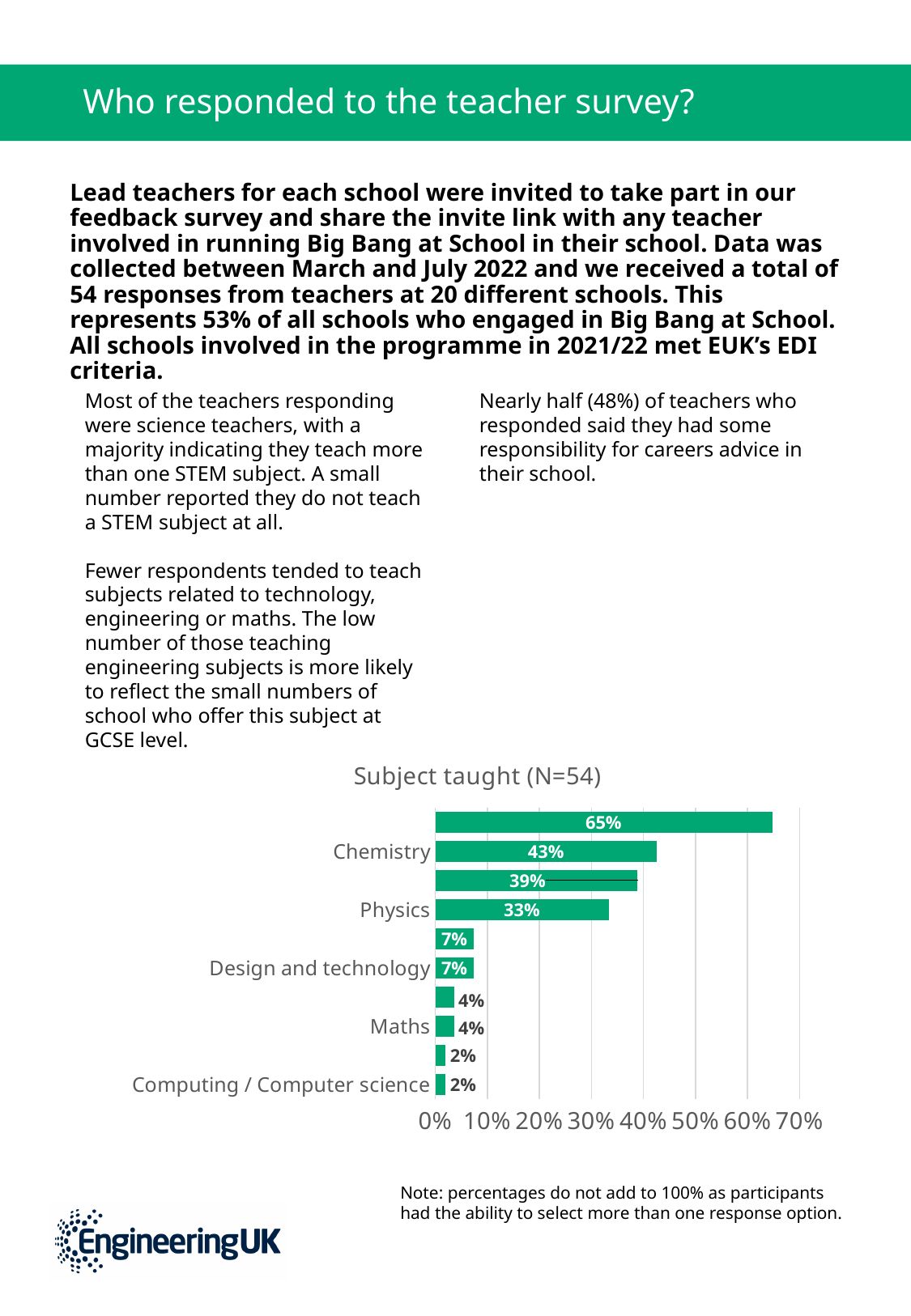
Which is larger, the value for Chemistry or the value for Physics? Chemistry What kind of chart is shown under the title "Subject taught (N=54)"? bar chart What percentage of respondents teach Physics? 33% How many bars are plotted in the chart? 10 What is the title of the chart? Subject taught (N=54) What is the value for Design and technology? 7% What percentage of respondents teach Chemistry? 43% What is the value for Computing / Computer science? 2% What is the largest value shown on any bar in the chart? 65% What is the difference between the Chemistry value and the Physics value? 10% What is the value for Maths? 4% Is the value for Chemistry greater or less than 40%? greater